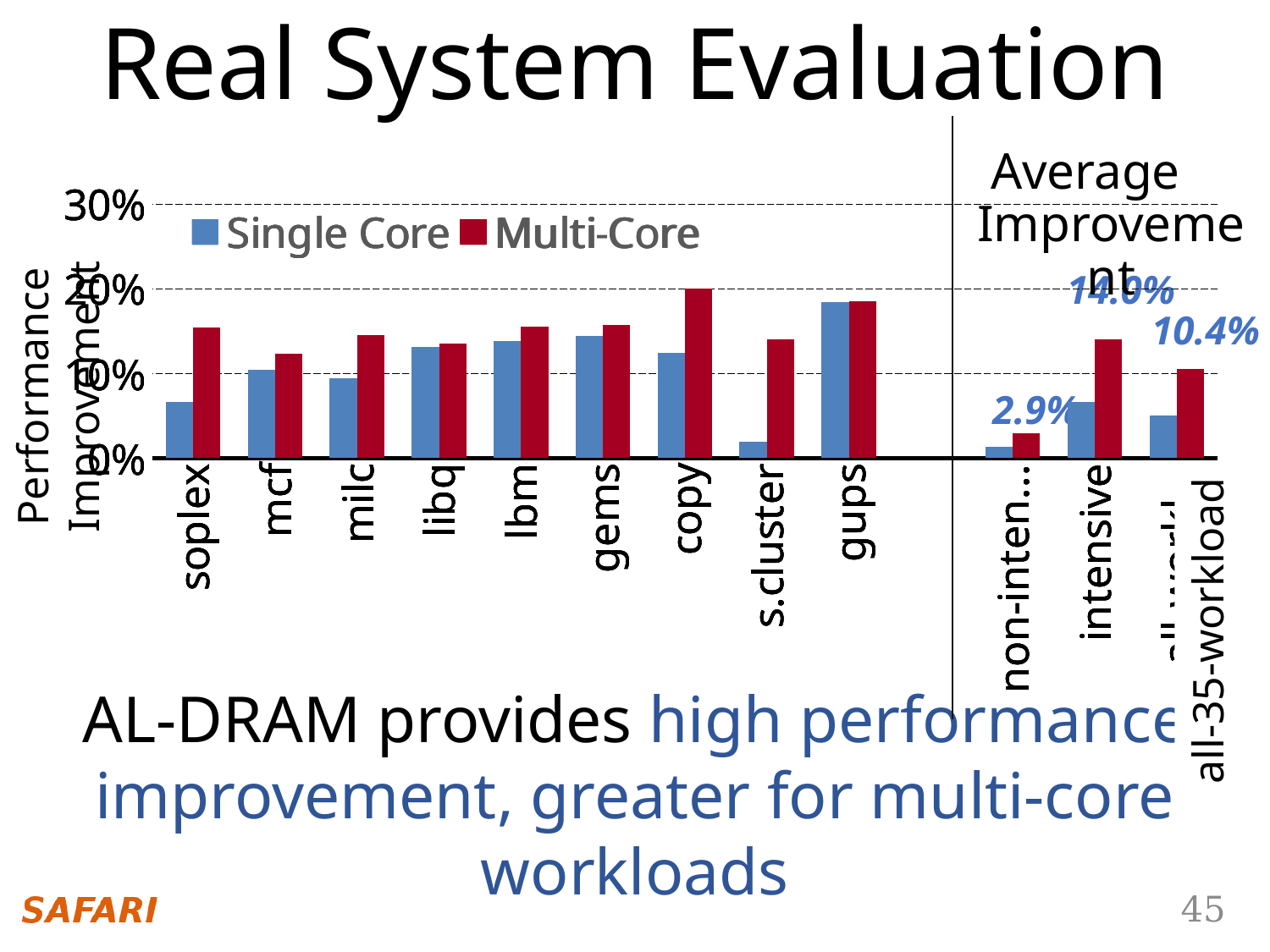
For s.cluster, which is larger: the Single Core or the Multi-Core performance improvement? Multi-Core Among the nine benchmarks left of the divider, which has the lowest Single Core performance improvement? s.cluster Which benchmark has the highest Single Core performance improvement? gups What average improvement value is labelled next to the intensive workload bars? 14.0% Is the Single Core performance improvement for gups greater or less than 10%? greater What are the two series named in the chart's legend? Single Core and Multi-Core Is the Single Core performance improvement for s.cluster greater or less than 10%? less What kind of chart is shown on the slide? bar chart For soplex, which is larger: the Single Core or the Multi-Core performance improvement? Multi-Core How many series does the chart's legend list? 2 Which benchmark has the highest Multi-Core performance improvement? copy Which colour represents the Multi-Core series in the chart? red